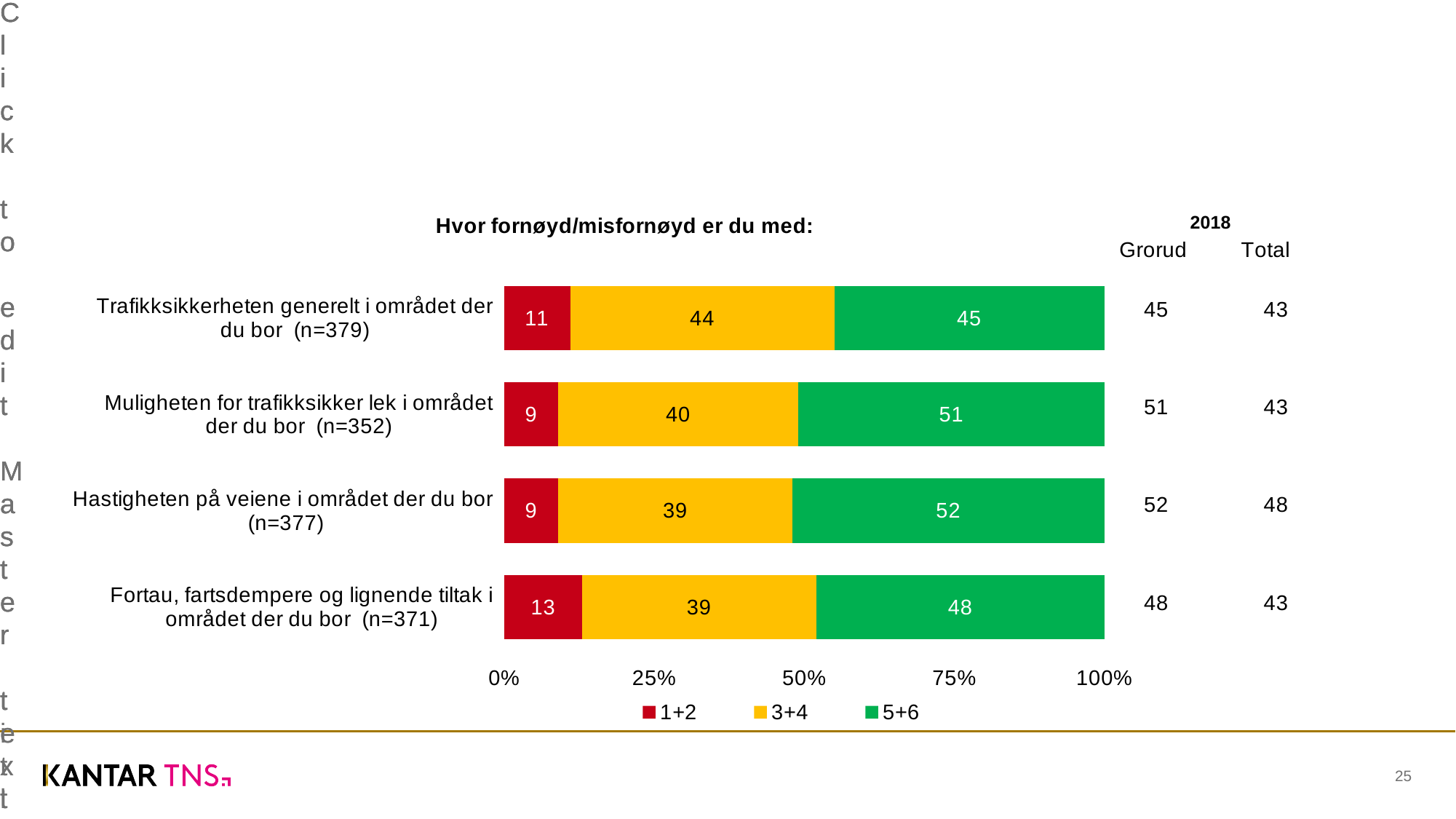
Which is larger: the 1+2 value for "Fortau, fartsdempere og lignende tiltak i området der du bor" or the 1+2 value for "Muligheten for trafikksikker lek i området der du bor"? Fortau, fartsdempere og lignende tiltak i området der du bor What kind of chart is shown on the slide? Stacked bar chart How many categories are plotted in the chart? 4 What is the title of the chart? Hvor fornøyd/misfornøyd er du med: How many series does the legend list? 3 What is the 1+2 value for "Fortau, fartsdempere og lignende tiltak i området der du bor"? 13 What is the 5+6 value for "Hastigheten på veiene i området der du bor"? 52 What is the difference between the 5+6 value for "Muligheten for trafikksikker lek i området der du bor" and the 5+6 value for "Trafikksikkerheten generelt i området der du bor"? 6 What is the 3+4 value for "Trafikksikkerheten generelt i området der du bor"? 44 Which category has the lowest 5+6 value? Trafikksikkerheten generelt i området der du bor What is the total of the stacked bar for "Muligheten for trafikksikker lek i området der du bor"? 100 Which category has the highest 5+6 value? Hastigheten på veiene i området der du bor